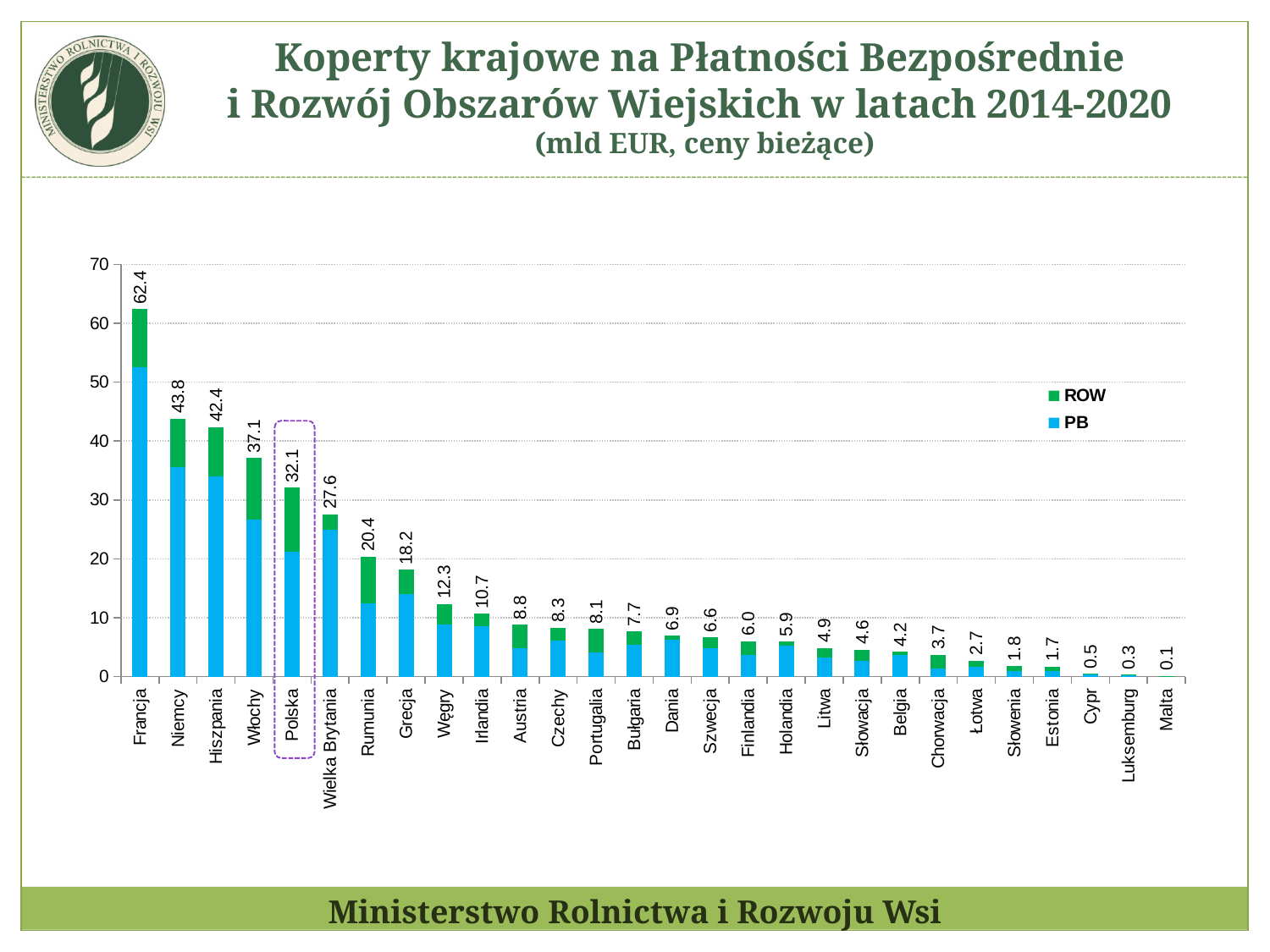
What kind of chart is shown on the slide? Stacked bar chart Which has a larger total, Włochy or Wielka Brytania? Włochy What is the total value labelled for Polska? 32.1 How many countries are shown on the x axis? 28 What is the difference between the labelled totals for Niemcy and Hiszpania? 1.4 What is the difference between the labelled totals for Francja and Polska? 30.3 Which country has the lowest total bar? Malta Which country has the highest total bar? Francja How many series does the legend list? 2 What is the total value labelled for Rumunia? 20.4 Is the PB (blue) segment for Francja greater or less than 50? greater Is the PB (blue) segment for Polska greater or less than 30? less